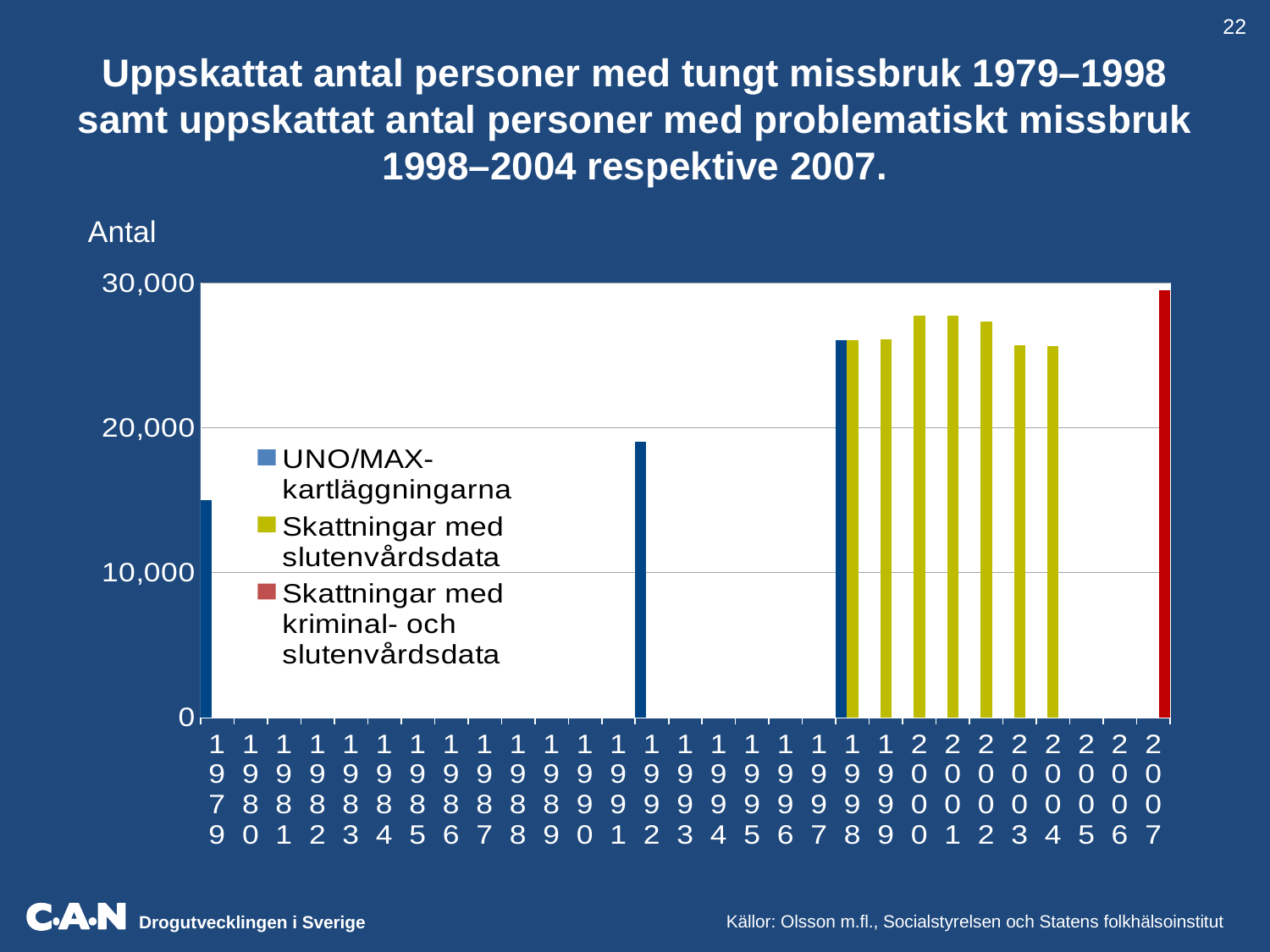
How many bars are plotted for the series 'UNO/MAX-kartläggningarna'? 3 Which series is shown in red in the legend? Skattningar med kriminal- och slutenvårdsdata What kind of chart is shown on the slide? bar chart Which year has the lowest bar in the chart? 1979 Which year has the highest bar in the chart? 2007 Is the value for 1992 greater or less than 20,000? less Which is larger, the value for 1979 or the value for 1992? 1992 Is the value for 2007 greater or less than 20,000? greater Is the value for 1979 greater or less than 10,000? greater How many series does the legend list? 3 How many years are labelled along the x axis? 29 How many bars are plotted for the series 'Skattningar med slutenvårdsdata'? 7